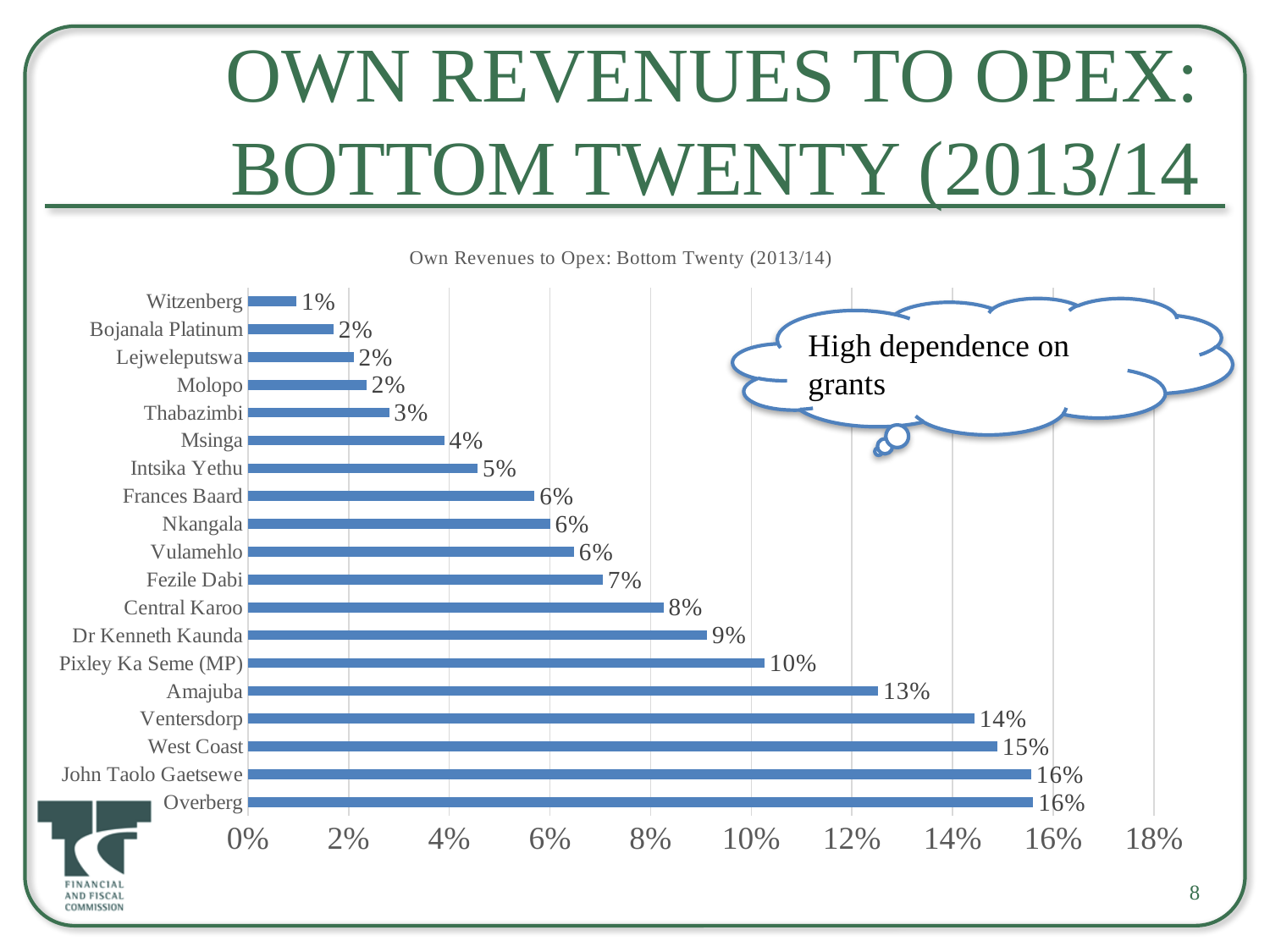
What kind of chart is shown on the slide? Bar chart What is the title of the chart? Own Revenues to Opex: Bottom Twenty (2013/14) What is the value for West Coast? 15% What is the value for Dr Kenneth Kaunda? 9% What is the value for Amajuba? 13% What is the value for Pixley Ka Seme (MP)? 10% Which municipality has the lowest value? Witzenberg What is the value for Witzenberg? 1% Which is larger, the value for Ventersdorp or the value for Central Karoo? Ventersdorp What is the difference between the values for Amajuba and Witzenberg? 12% What is the difference between the values for Ventersdorp and Central Karoo? 6% Is the value for Fezile Dabi greater or less than 6%? greater